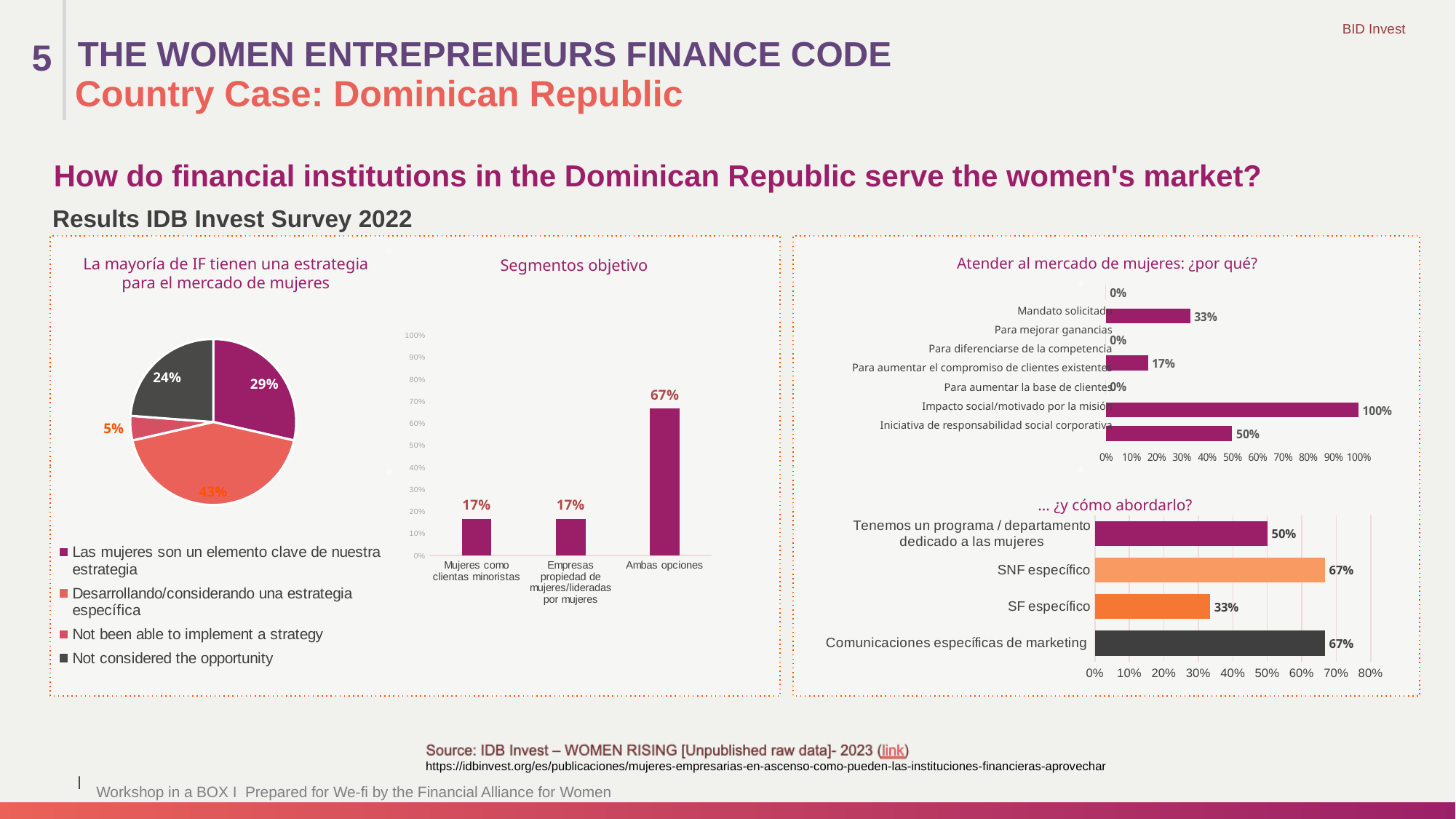
In the 'Atender al mercado de mujeres: ¿por qué?' chart, what is the value for 'Iniciativa de responsabilidad social corporativa'? 50% In the pie chart 'La mayoría de IF tienen una estrategia para el mercado de mujeres', how many categories does the legend list? 4 In the '… ¿y cómo abordarlo?' chart, how many categories are shown? 4 What kind of chart is 'Segmentos objetivo'? Bar chart In the pie chart 'La mayoría de IF tienen una estrategia para el mercado de mujeres', which category has the largest slice? Desarrollando/considerando una estrategia específica In the '… ¿y cómo abordarlo?' chart, what is the value for 'SF específico'? 33% In the 'Atender al mercado de mujeres: ¿por qué?' chart, what is the value for 'Impacto social/motivado por la misión'? 100% In the 'Segmentos objetivo' chart, what is the value for 'Ambas opciones'? 67% In the pie chart 'La mayoría de IF tienen una estrategia para el mercado de mujeres', what share is 'Not considered the opportunity'? 24% In the '… ¿y cómo abordarlo?' chart, which is larger: 'SNF específico' or 'Tenemos un programa / departamento dedicado a las mujeres'? SNF específico In the pie chart 'La mayoría de IF tienen una estrategia para el mercado de mujeres', which category has the smallest slice? Not been able to implement a strategy In the 'Segmentos objetivo' chart, what is the difference between 'Ambas opciones' and 'Mujeres como clientas minoristas'? 50%